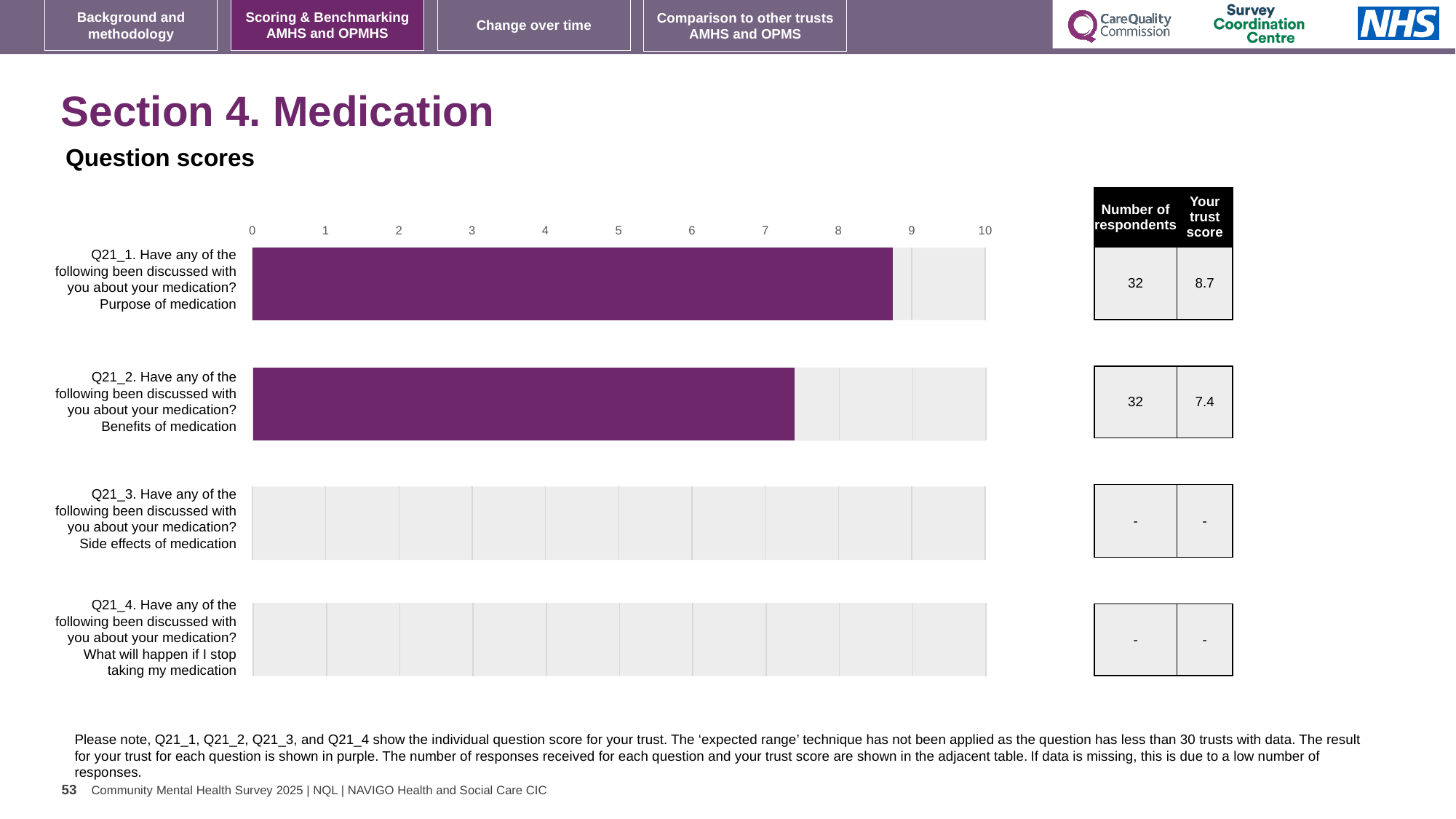
How many respondents answered Q21_1 (Purpose of medication)? 32 What is the maximum value shown on the chart's axis? 10 What is the difference between the trust scores for Q21_1 (Purpose of medication) and Q21_2 (Benefits of medication)? 1.3 What is the trust score for Q21_2 (Benefits of medication)? 7.4 Which question has the highest trust score on the chart? Q21_1. Purpose of medication Is the trust score for Q21_1 (Purpose of medication) greater or less than 8? greater Which has a larger trust score, Q21_1 (Purpose of medication) or Q21_2 (Benefits of medication)? Q21_1. Purpose of medication What is the trust score for Q21_1 (Purpose of medication)? 8.7 What kind of chart is shown on the slide? Bar chart How many questions are listed on the chart? 4 Is the trust score for Q21_2 (Benefits of medication) greater or less than 8? less What colour is used to show the trust's result for each question? Purple